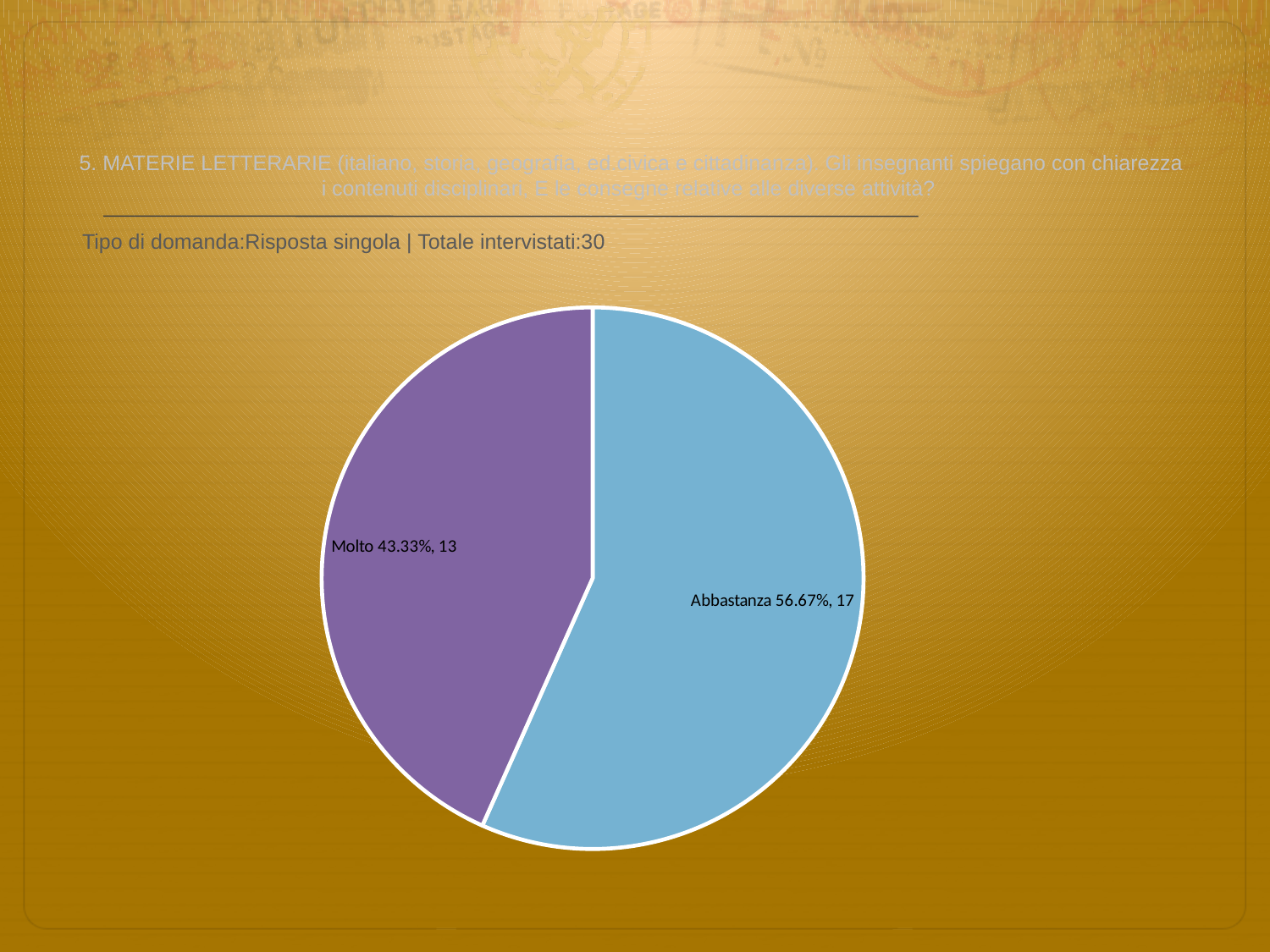
Which slice is the smallest in the pie chart? Molto What is the total number of respondents across both slices? 30 What colour is the Molto slice? purple Which has more respondents, Molto or Abbastanza? Abbastanza What is the difference in respondent count between Abbastanza and Molto? 4 What percentage of the pie is the Abbastanza slice? 56.67% Which slice is the largest in the pie chart? Abbastanza How many slices does the pie chart have? 2 How many respondents answered Abbastanza? 17 What percentage of the pie is the Molto slice? 43.33% How many respondents answered Molto? 13 What kind of chart is shown on the slide? pie chart